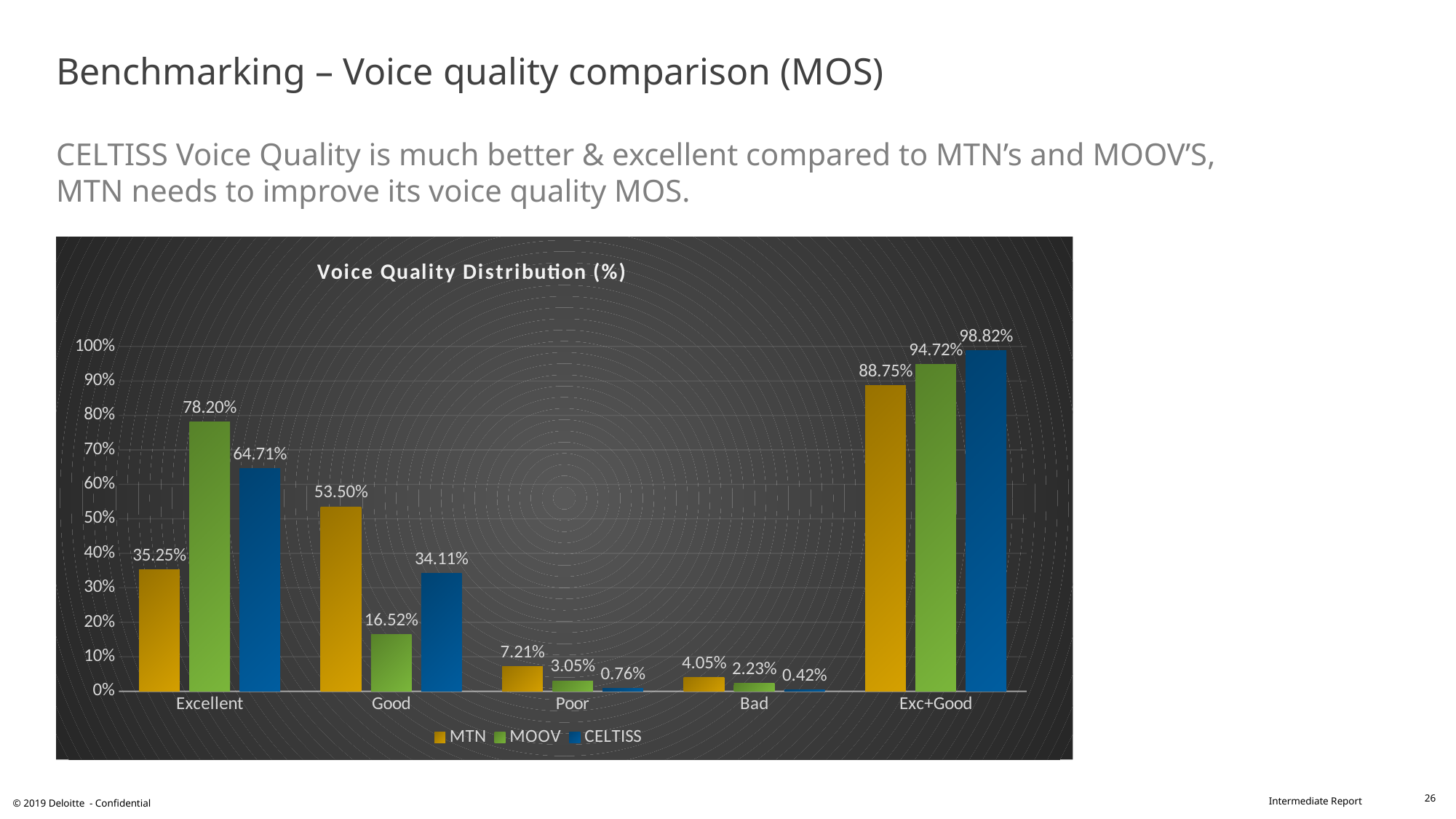
What kind of chart is shown on the slide? Bar chart Which is larger for the Good category: MTN or CELTISS? MTN How many series does the legend list? 3 Which operator has the lowest value in the Bad category? CELTISS What is the MTN value for the Poor category? 7.21% What is the CELTISS value for the Good category? 34.11% What is the difference between the MOOV and MTN values for Excellent? 42.95% What is the MOOV value for the Excellent category? 78.20% What is the title of the chart? Voice Quality Distribution (%) Is the MTN value for Exc+Good greater or less than 90%? less Which operator has the highest value in the Exc+Good category? CELTISS How many categories are shown on the x axis? 5